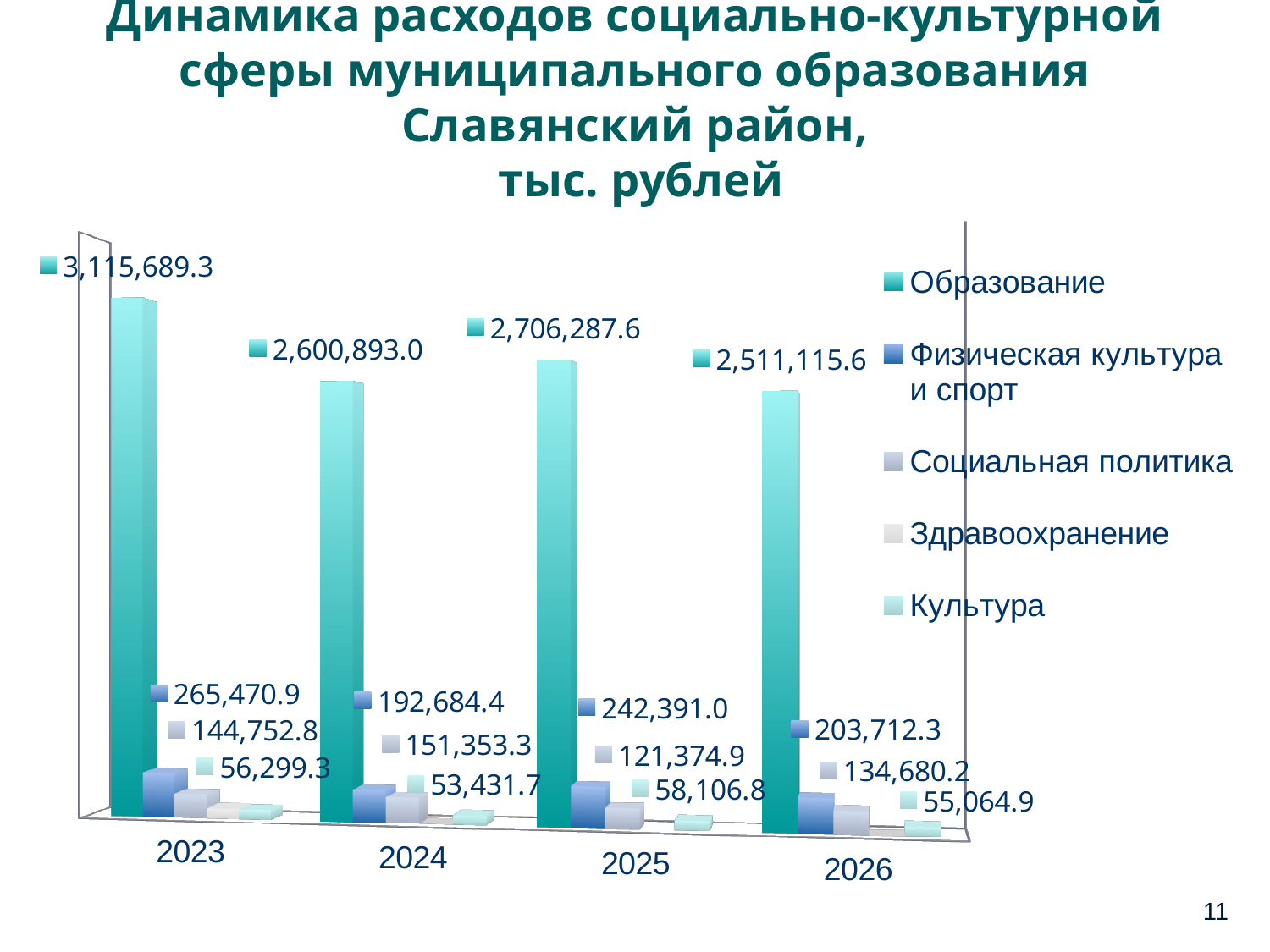
Which series is shown in the tallest bars? Образование Which is larger: Социальная политика in 2023 or Социальная политика in 2024? 2024 What is the value for Физическая культура и спорт in 2025? 242,391.0 How many series does the legend list? 5 What is the value for Социальная политика in 2024? 151,353.3 What kind of chart is shown on the slide? bar chart How many years are shown on the x axis? 4 In which year is the value for Образование the highest? 2023 What is the value for Образование in 2023? 3,115,689.3 What is the value for Культура in 2026? 55,064.9 In which year is the value for Физическая культура и спорт the lowest? 2024 What is the difference between the Образование values for 2023 and 2024? 514,796.3